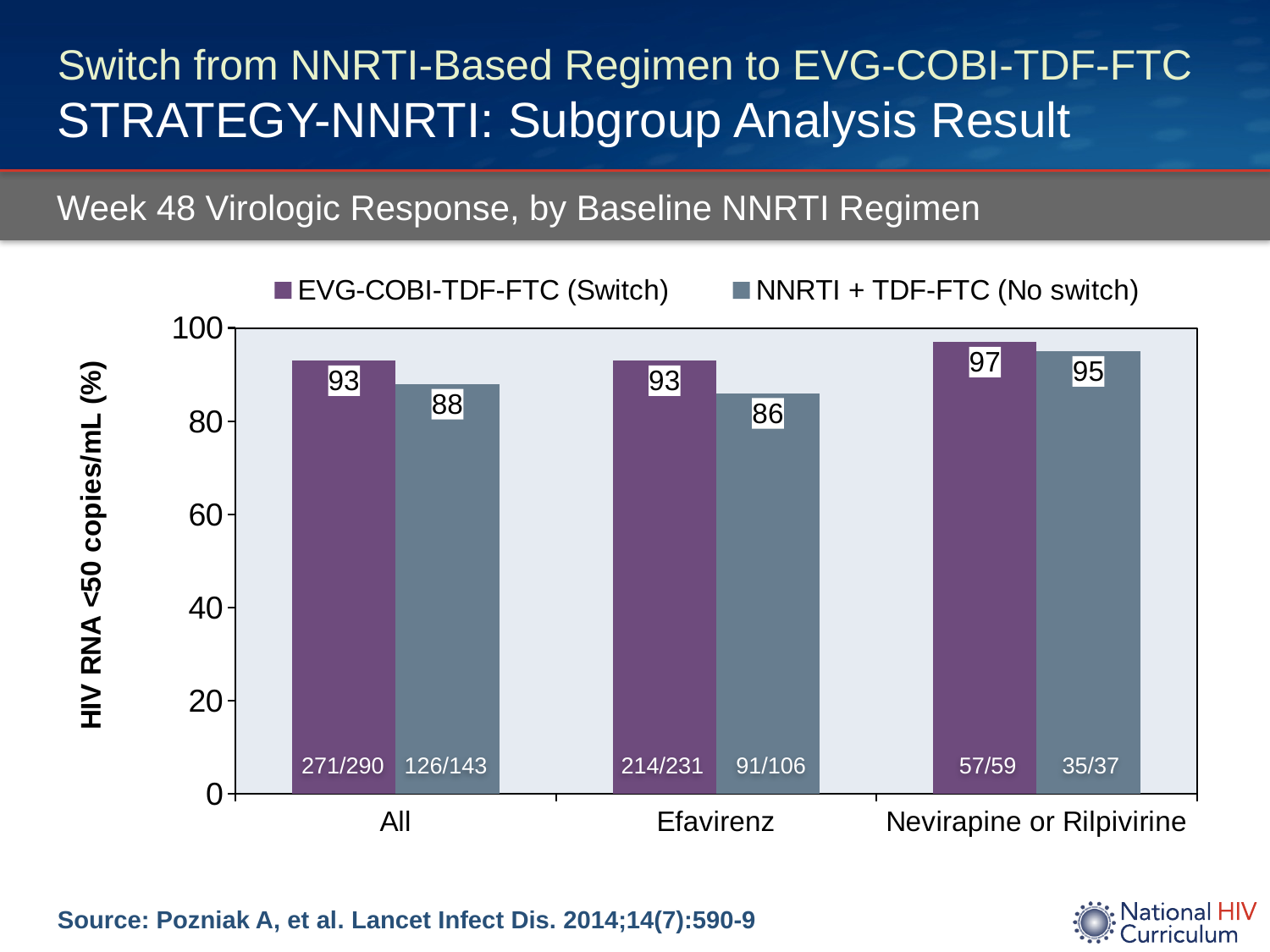
What is the Week 48 virologic response (%) for EVG-COBI-TDF-FTC (Switch) in the All group? 93 Which baseline NNRTI regimen group has the lowest response for NNRTI + TDF-FTC (No switch)? Efavirenz What kind of chart is shown on the slide? Bar chart What is the difference in percentage points between the Switch and No switch arms in the Efavirenz group? 7 How many series does the legend list? 2 What is the Week 48 virologic response (%) for NNRTI + TDF-FTC (No switch) in the Efavirenz group? 86 What is the value for NNRTI + TDF-FTC (No switch) in the Nevirapine or Rilpivirine group? 95 How many baseline NNRTI regimen groups are shown on the x axis? 3 Which baseline NNRTI regimen group has the highest response for EVG-COBI-TDF-FTC (Switch)? Nevirapine or Rilpivirine In the Nevirapine or Rilpivirine group, which arm has the higher response: EVG-COBI-TDF-FTC (Switch) or NNRTI + TDF-FTC (No switch)? EVG-COBI-TDF-FTC (Switch) What is the difference in percentage points between the Switch and No switch arms in the All group? 5 What fraction is printed at the base of the EVG-COBI-TDF-FTC (Switch) bar in the Efavirenz group? 214/231